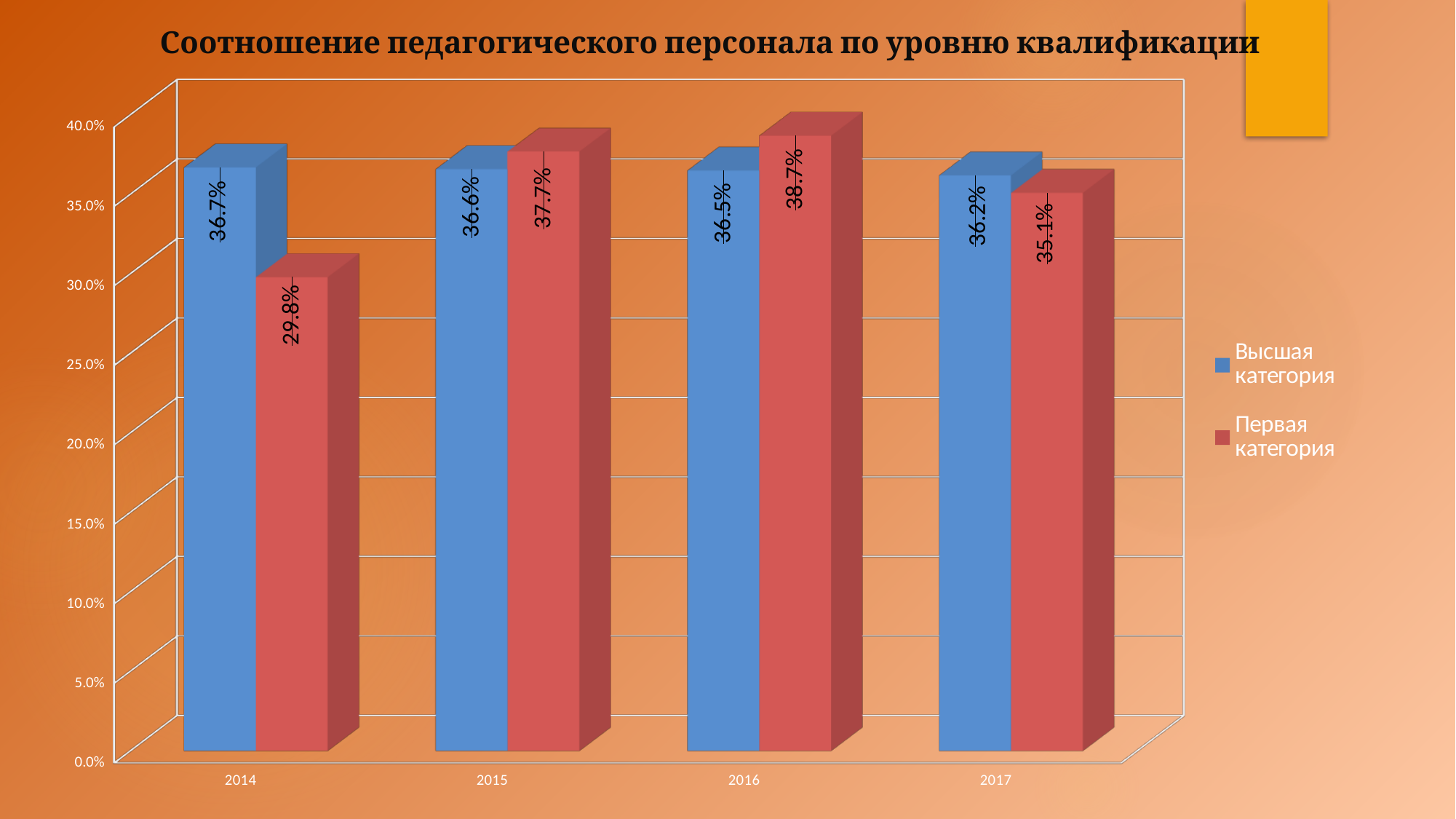
In which year is Первая категория highest? 2016 Which is larger in 2015, Высшая категория or Первая категория? Первая категория What is the value for Высшая категория in 2014? 36.7% How many series does the legend list? 2 What is the value for Первая категория in 2016? 38.7% What is the value for Первая категория in 2017? 35.1% How many years are shown on the x axis? 4 What kind of chart is shown? bar chart Is the value for Первая категория in 2014 greater or less than 30.0%? less Does Высшая категория rise or fall from 2014 to 2017? fall In which year is Первая категория lowest? 2014 What is the difference between Высшая категория and Первая категория in 2014? 6.9%